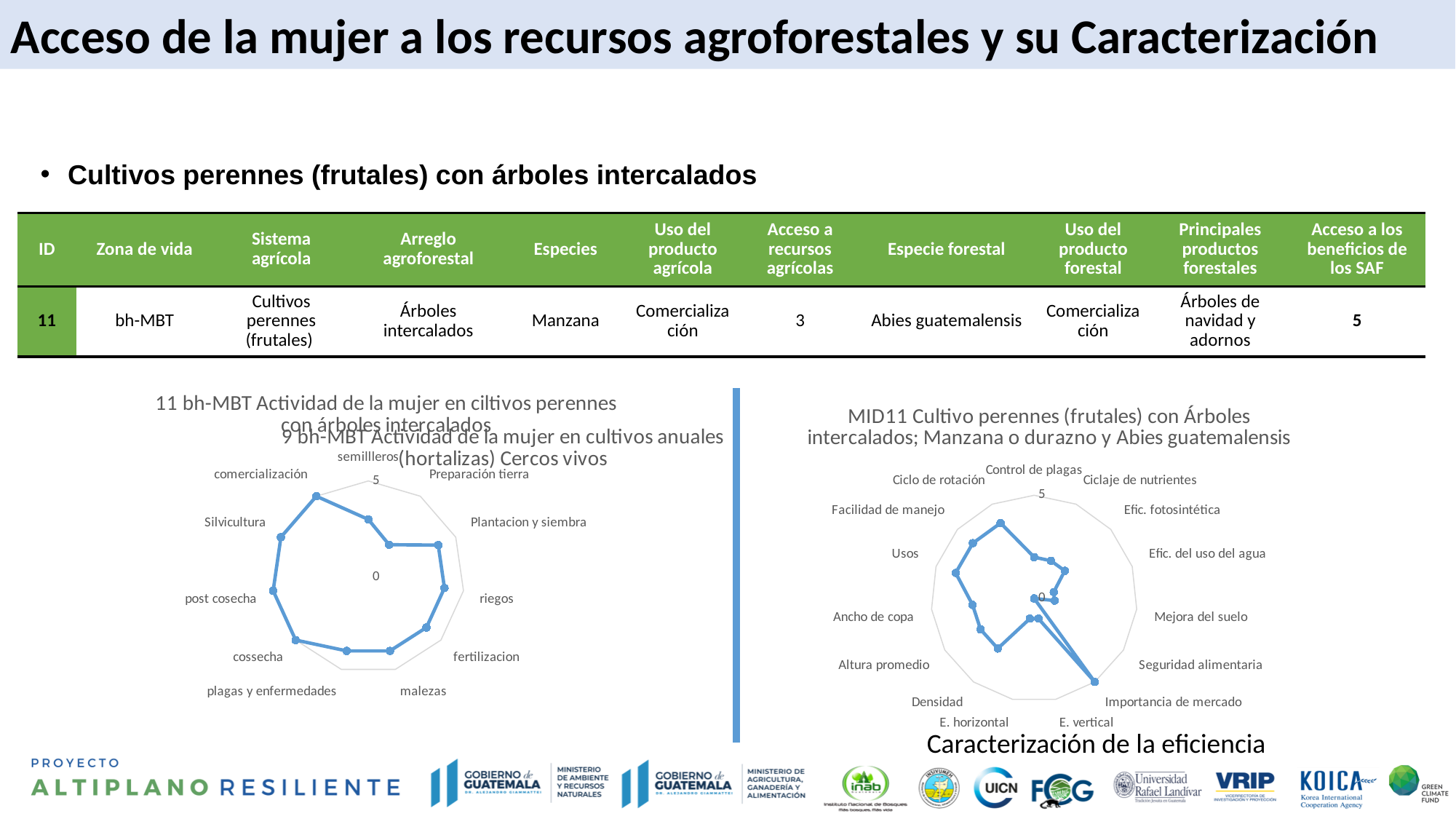
How many categories are plotted on the right radar chart (MID11 Cultivo perennes)? 15 What kind of chart is the chart on the left of the slide? Radar chart On the left radar chart (11 bh-MBT Actividad de la mujer), which is larger: the value for comercialización or the value for semillleros? comercialización On the right radar chart (MID11 Cultivo perennes), is the value for Control de plagas greater or less than 5? less What text appears below the right radar chart as its caption? Caracterización de la eficiencia How many categories are plotted on the left radar chart (11 bh-MBT Actividad de la mujer)? 11 What is the maximum value shown on the axis of the right radar chart (MID11 Cultivo perennes)? 5 On the right radar chart (MID11 Cultivo perennes), which is larger: the value for Seguridad alimentaria or the value for Control de plagas? Control de plagas What kind of chart is the chart on the right of the slide? Radar chart On the left radar chart (11 bh-MBT Actividad de la mujer), which category has the lowest value? Preparación tierra On the left radar chart (11 bh-MBT Actividad de la mujer), is the value for semillleros greater or less than 5? less On the right radar chart (MID11 Cultivo perennes), which category has the highest value? Importancia de mercado